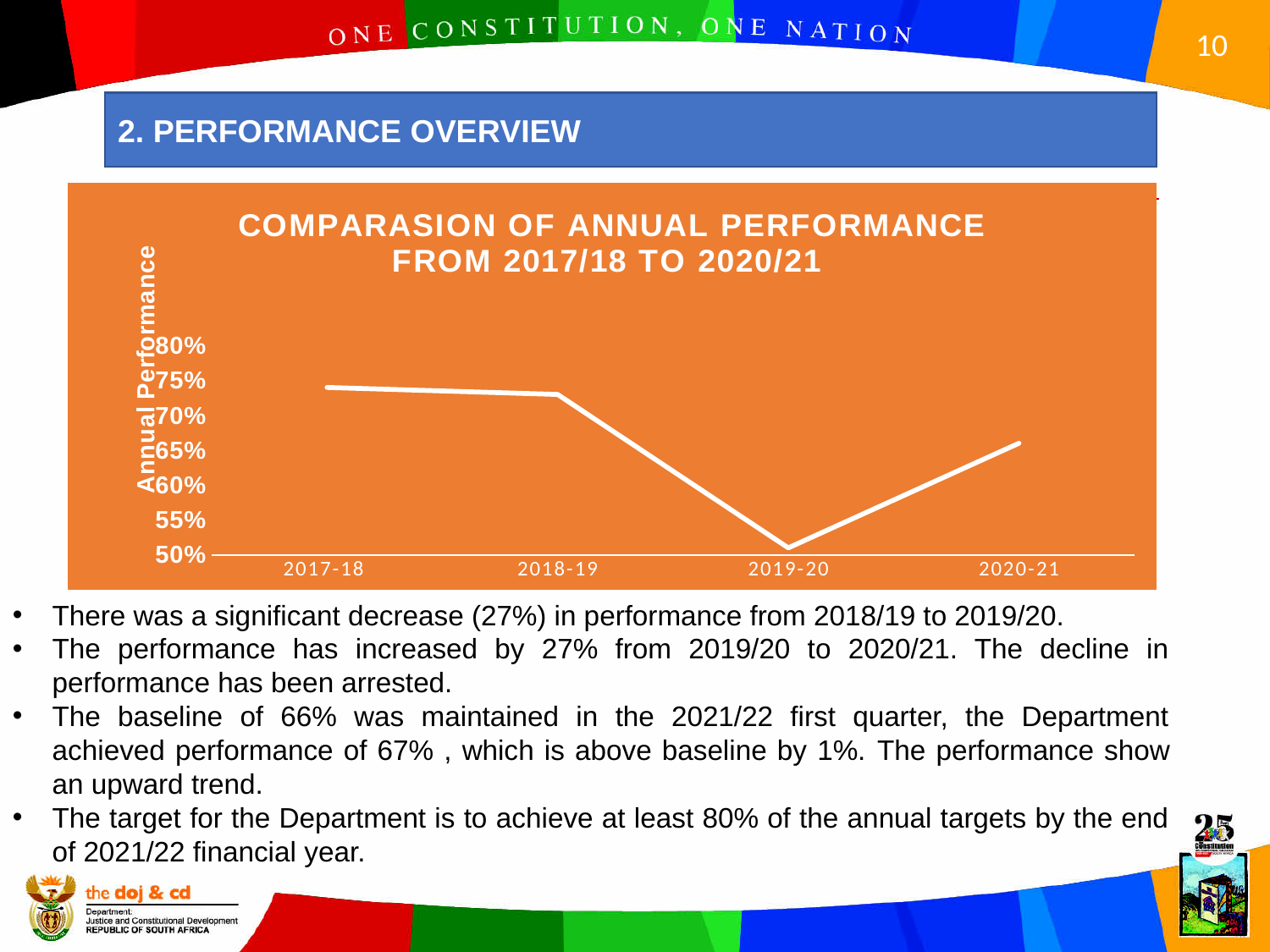
Is the value for 2019-20 greater or less than 55%? less Is the value for 2017-18 greater or less than 70%? greater Is the value for 2018-19 greater or less than 70%? greater Which financial year has the lowest annual performance on the chart? 2019-20 Does the annual performance rise or fall from 2018-19 to 2019-20? fall How many financial years are plotted on the chart? 4 Which is larger, the value for 2018-19 or the value for 2019-20? 2018-19 What is the label on the vertical axis of the chart? Annual Performance What kind of chart is shown on the slide? line chart What is the title of the chart? COMPARASION OF ANNUAL PERFORMANCE FROM 2017/18 TO 2020/21